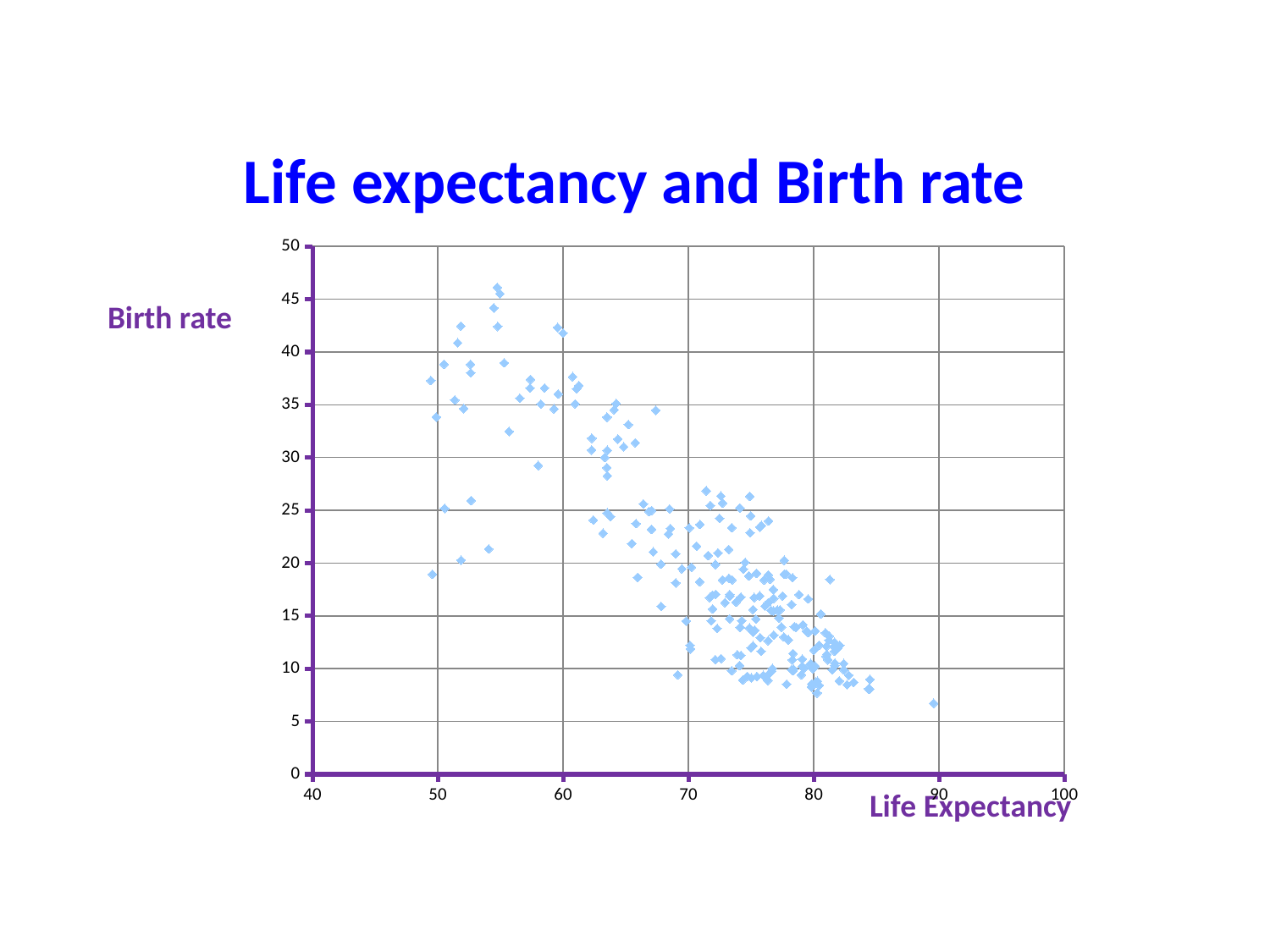
Are all the plotted birth rate values less than 50? Yes Are there any points plotted with a life expectancy greater than 90? No What kind of chart is shown on the slide? Scatter plot What is the title of the chart? Life expectancy and Birth rate As life expectancy increases along the x axis, does birth rate generally rise or fall? Fall Is the relationship between life expectancy and birth rate shown in the chart positive or negative? Negative What is the label of the horizontal axis? Life Expectancy What is the highest value shown on the vertical (birth rate) axis? 50